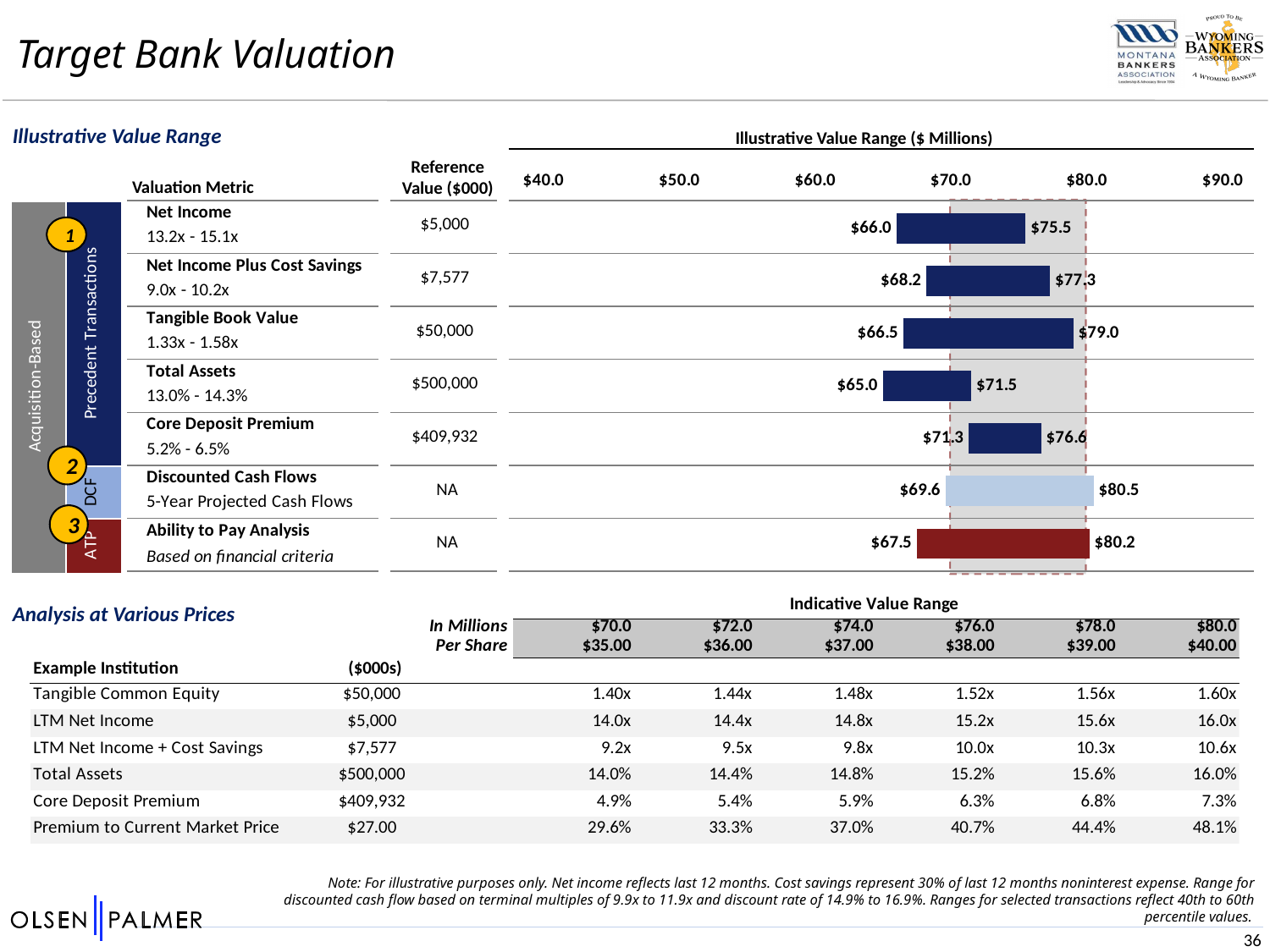
What is the unit stated in the title of the Illustrative Value Range chart? $ Millions How many valuation metrics are plotted in the Illustrative Value Range chart? 7 In the Illustrative Value Range chart, which valuation metric has the lowest low-end value? Total Assets In the Illustrative Value Range chart, what is the high end of the value range for Discounted Cash Flows? $80.5 In the Illustrative Value Range chart, which has a higher high-end value: Tangible Book Value or Total Assets? Tangible Book Value In the Illustrative Value Range chart, what is the low end of the value range for Net Income? $66.0 In the Illustrative Value Range chart, is the high-end value for Total Assets greater or less than $80.0? less In the Illustrative Value Range chart, what is the high end of the value range for Tangible Book Value? $79.0 In the Illustrative Value Range chart, what is the low end of the value range for Core Deposit Premium? $71.3 What kind of chart is the Illustrative Value Range chart? Bar chart In the Illustrative Value Range chart, which valuation metric has the highest high-end value? Discounted Cash Flows In the Illustrative Value Range chart, what is the difference between the high and low ends of the Net Income range? $9.5